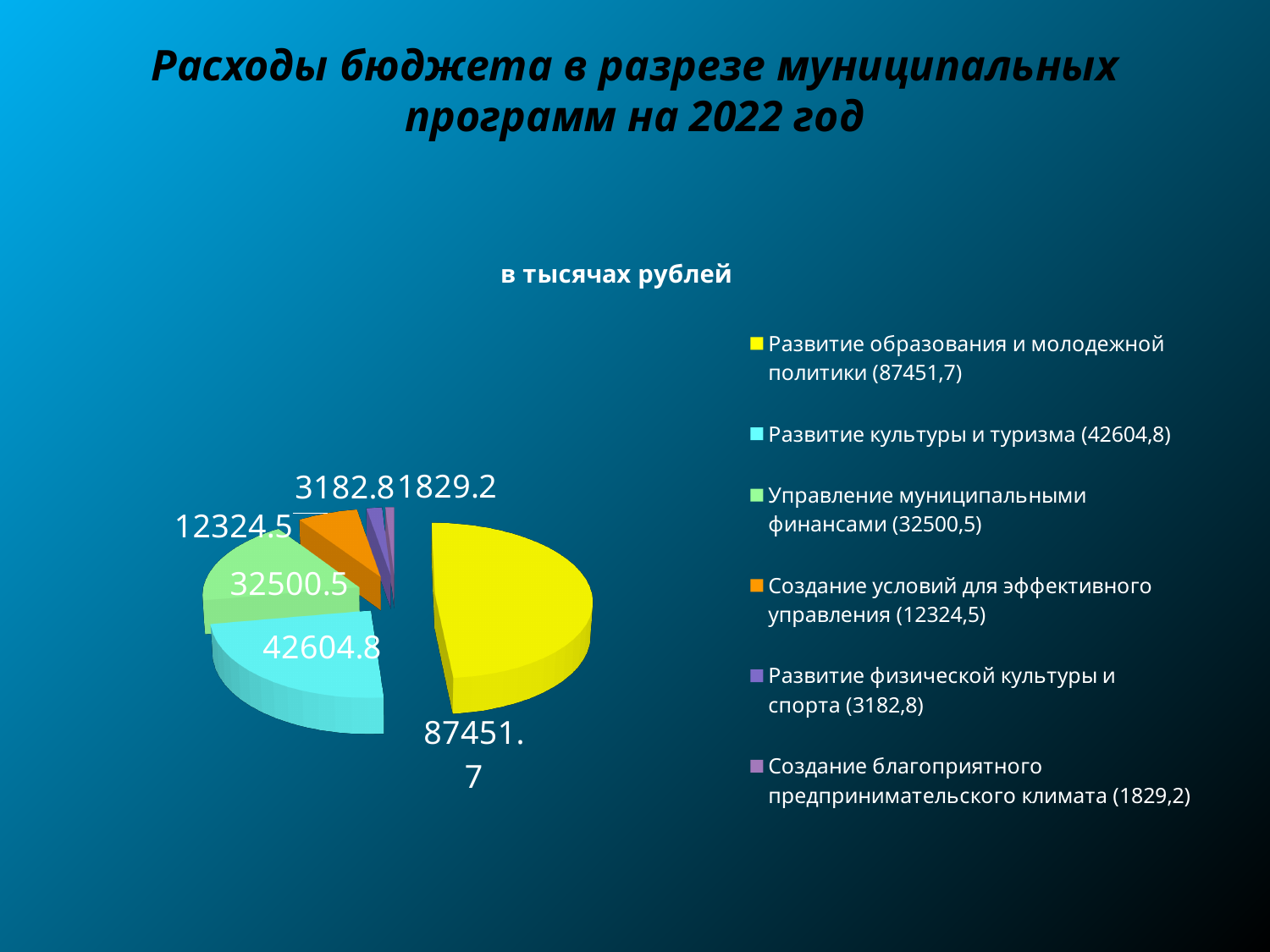
What is the value for «Развитие образования и молодежной политики»? 87451.7 What is the difference between the values for «Развитие образования и молодежной политики» and «Развитие культуры и туризма»? 44846.9 What type of chart is shown on the slide? Pie chart How many entries does the legend list? 6 In what units are the values on the chart expressed, according to the chart subtitle? в тысячах рублей Which program has the largest share of the budget expenses? Развитие образования и молодежной политики What is the value for «Управление муниципальными финансами»? 32500.5 What is the value for «Создание благоприятного предпринимательского климата»? 1829.2 Which program has the smallest share of the budget expenses? Создание благоприятного предпринимательского климата Which is larger: the value for «Развитие физической культуры и спорта» or for «Создание благоприятного предпринимательского климата»? Развитие физической культуры и спорта How many slices does the pie chart have? 6 What is the value for «Развитие культуры и туризма»? 42604.8